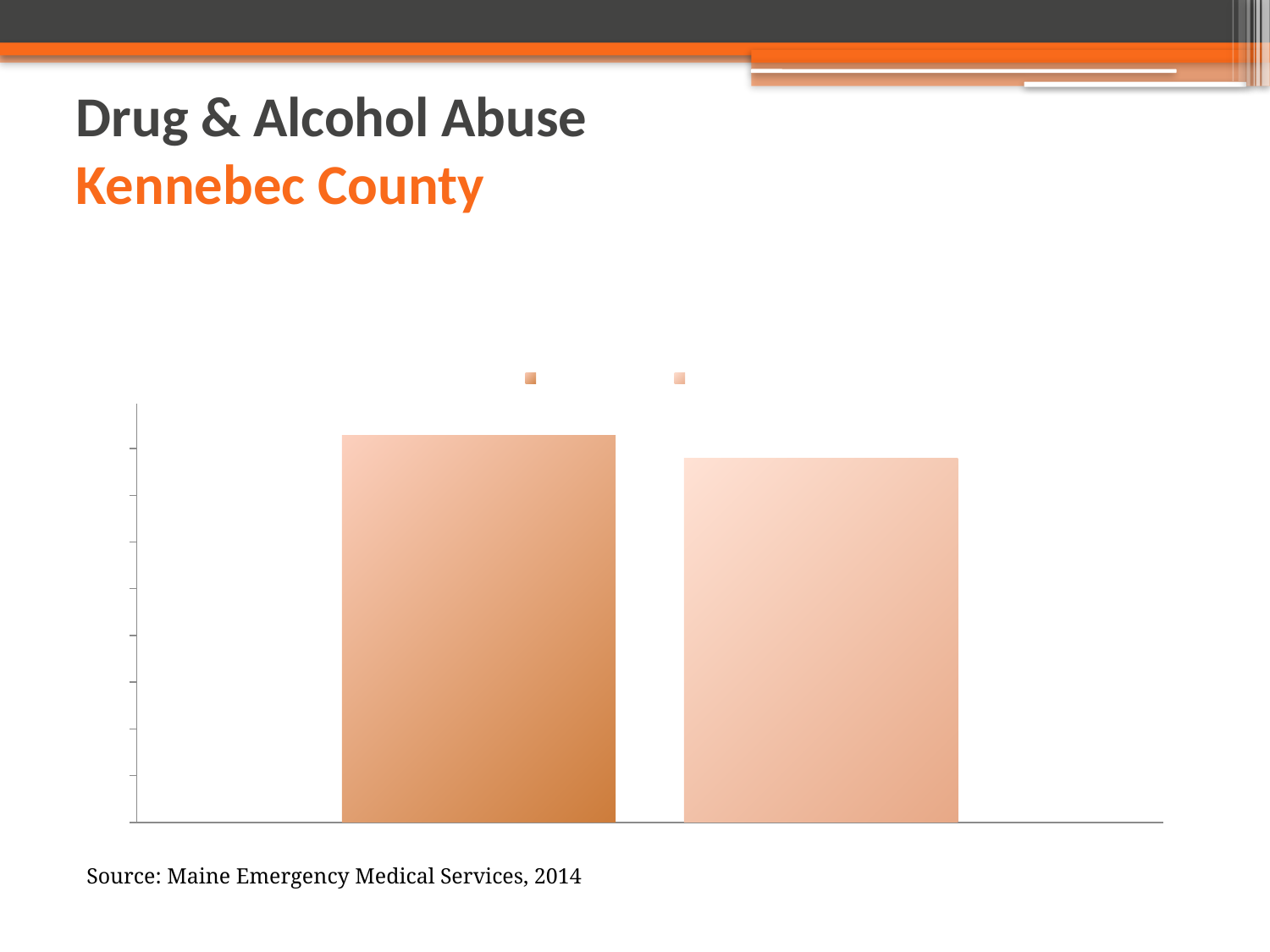
Which bar in the chart is the tallest? the left bar What kind of chart is shown on the slide? bar chart How many bars are plotted in the chart? 2 How many entries does the chart's legend show? 2 What source is cited below the chart? Maine Emergency Medical Services, 2014 Which bar is taller, the left bar or the right bar? the left bar Which county is named in the slide title above the chart? Kennebec County Which bar in the chart is the shortest? the right bar Do the bar heights rise or fall from left to right across the chart? fall